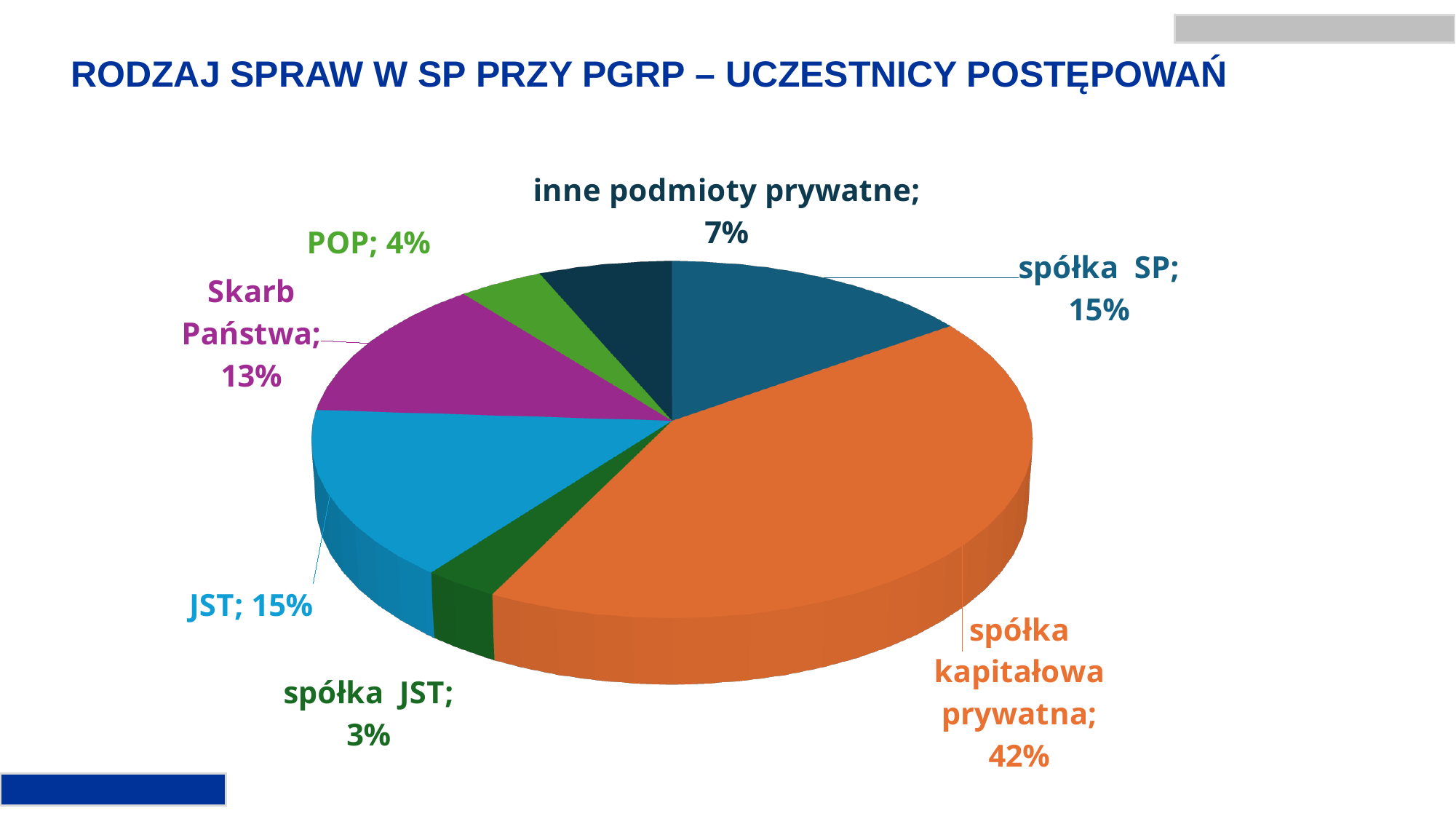
Which category has the largest slice of the pie? spółka kapitałowa prywatna What kind of chart is shown on the slide? pie chart Which is larger, the value for "Skarb Państwa" or the value for "JST"? JST What is the title of the slide containing the chart? RODZAJ SPRAW W SP PRZY PGRP – UCZESTNICY POSTĘPOWAŃ What is the value shown for "inne podmioty prywatne"? 7% What share of the pie does "spółka kapitałowa prywatna" have? 42% How many slices does the pie chart have? 7 What is the value shown for "Skarb Państwa"? 13% Which category has the smallest slice of the pie? spółka JST What is the value shown for "POP"? 4% What is the difference between the values for "spółka kapitałowa prywatna" and "spółka SP"? 27% What is the difference between the values for "inne podmioty prywatne" and "spółka JST"? 4%